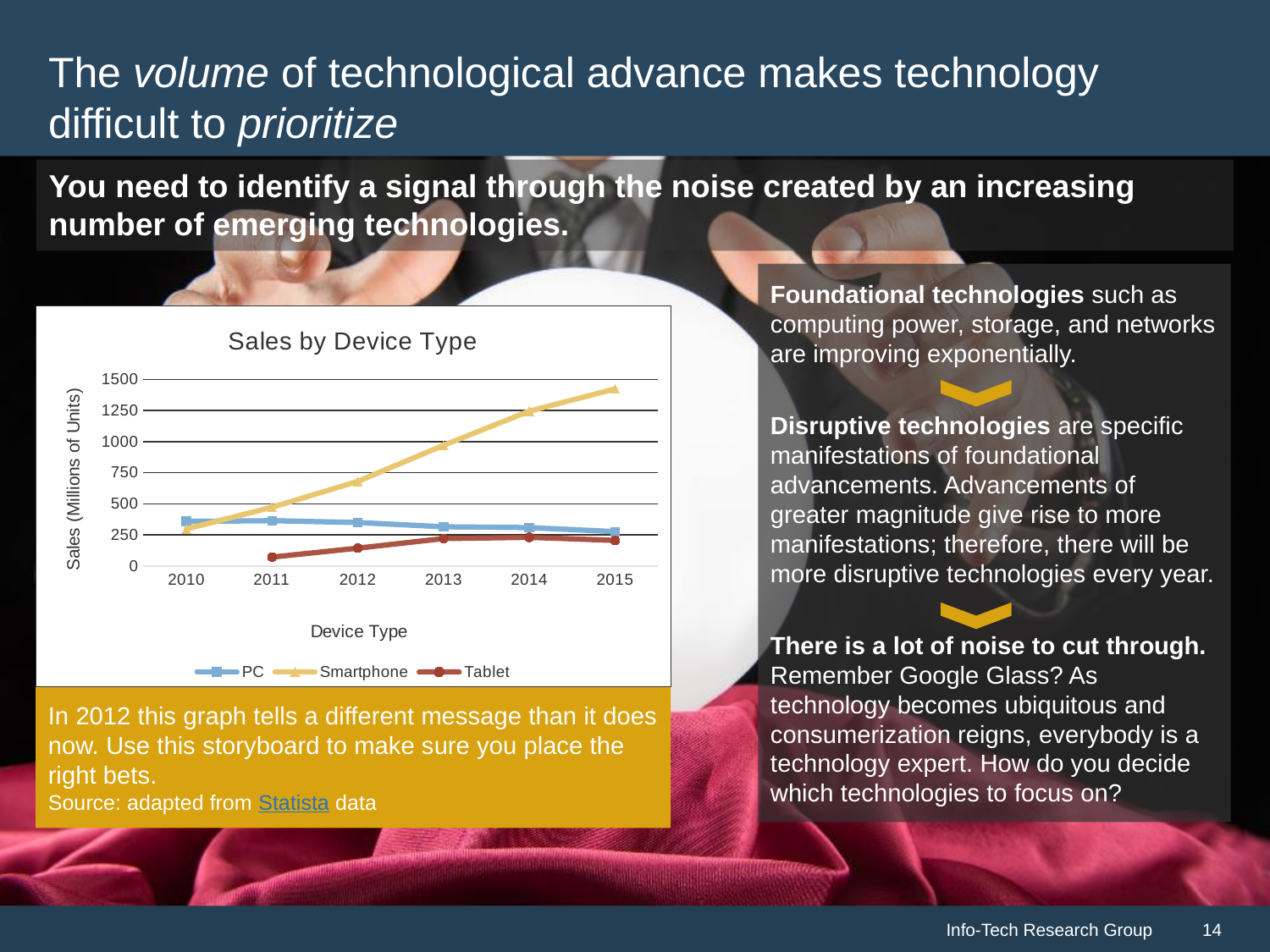
Is the Tablet value for 2011 greater or less than 250? less How many years are shown on the x axis of the "Sales by Device Type" chart? 6 How many series does the legend of the "Sales by Device Type" chart list? 3 Which device type has the highest sales in 2015? Smartphone Which device type has the lowest sales in 2015? Tablet Do Smartphone sales rise or fall from 2010 to 2015 in the "Sales by Device Type" chart? Rise What is the label on the vertical axis of the "Sales by Device Type" chart? Sales (Millions of Units) Is the Smartphone value for 2015 greater or less than 1250? greater Is the Smartphone value for 2012 greater or less than 750? less What kind of chart is "Sales by Device Type"? Line chart Do PC sales rise or fall from 2010 to 2015 in the "Sales by Device Type" chart? Fall In 2015, which is larger: Smartphone sales or PC sales? Smartphone